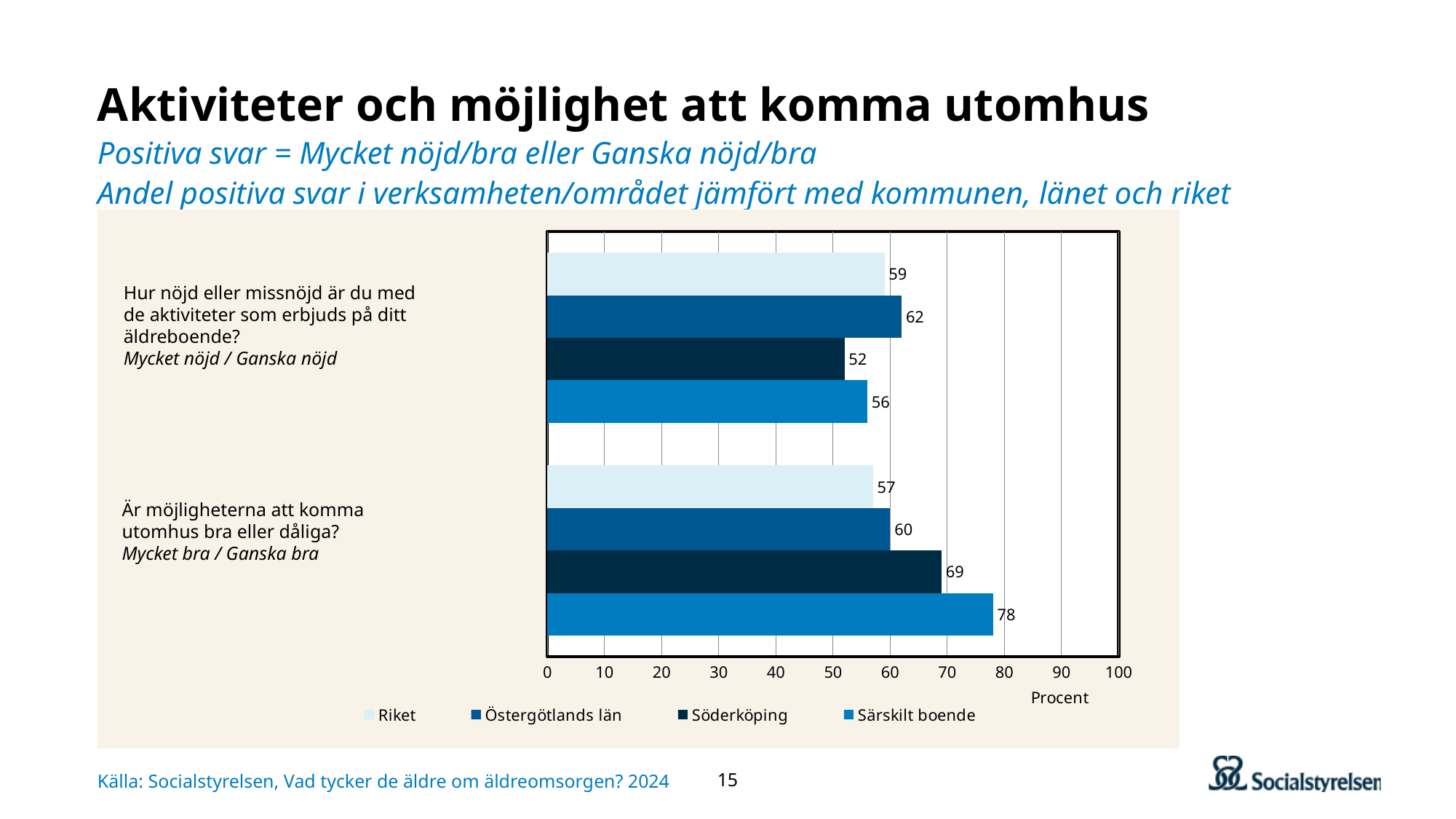
What unit is shown on the x axis of the chart? Procent What is the value for Söderköping on the question about satisfaction with activities offered (Hur nöjd eller missnöjd är du med de aktiviteter som erbjuds på ditt äldreboende?)? 52 What is the value for Särskilt boende on the question about opportunities to get outdoors (Är möjligheterna att komma utomhus bra eller dåliga?)? 78 What kind of chart is shown on the slide? Bar chart Which series has the lowest value on the question about satisfaction with activities offered? Söderköping How many series does the legend list? 4 What is the value for Riket on the question about opportunities to get outdoors? 57 What is the difference between Särskilt boende and Riket on the question about opportunities to get outdoors? 21 What is the difference between Östergötlands län and Söderköping on the question about satisfaction with activities offered? 10 How many question categories are shown on the chart? 2 Which series has the highest value on the question about opportunities to get outdoors? Särskilt boende Which is larger on the question about satisfaction with activities offered: Östergötlands län or Särskilt boende? Östergötlands län